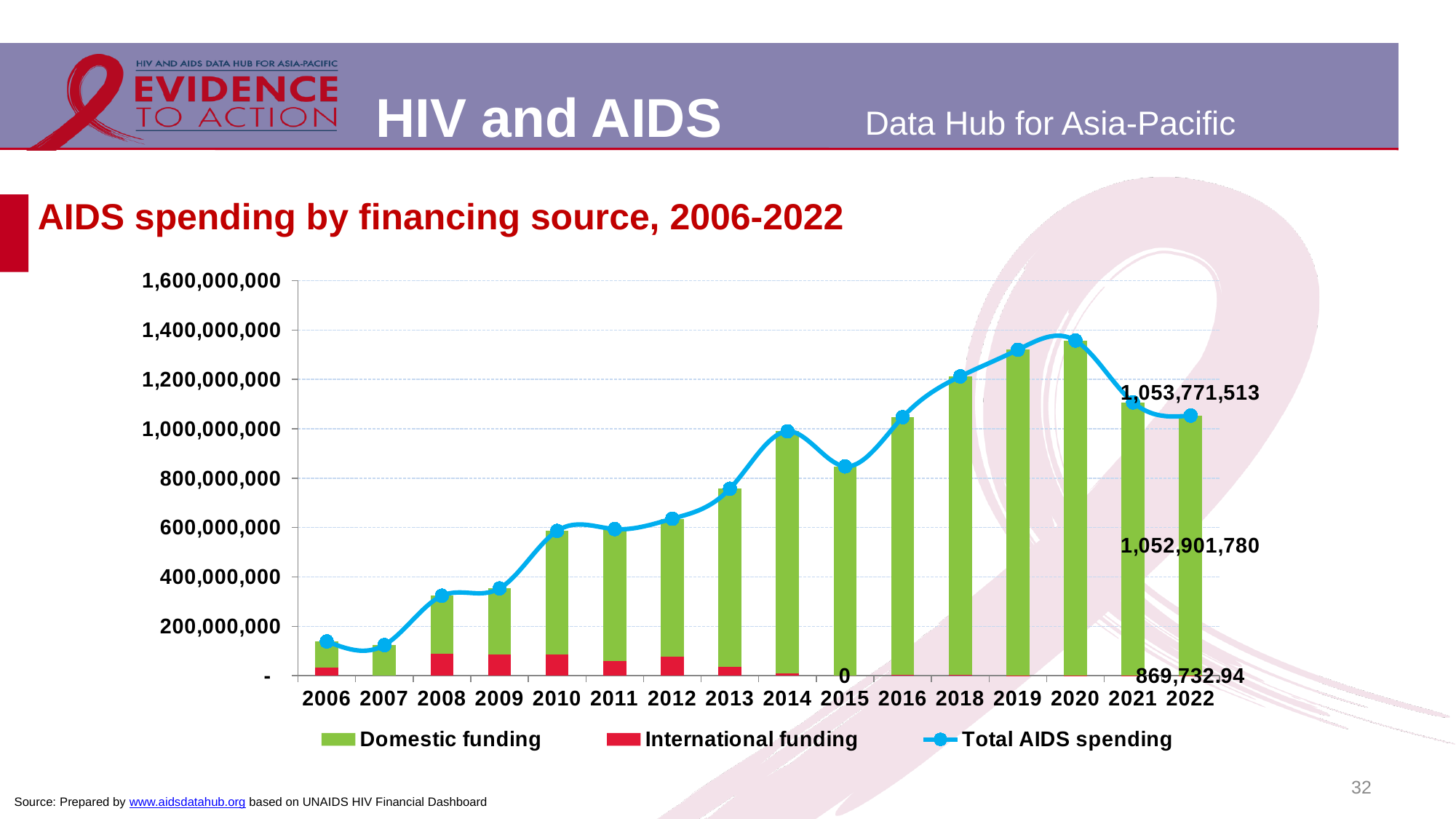
How many series does the legend list? 3 In which year is Total AIDS spending lowest? 2007 In which year is Total AIDS spending highest? 2020 What is the difference between Domestic funding and International funding in 2022? 1,052,032,047.06 Is Total AIDS spending higher in 2020 or in 2021? 2020 How many years are shown on the x axis? 16 What is the International funding value labelled for 2022? 869,732.94 What is the Domestic funding value labelled for 2022? 1,052,901,780 What is the Total AIDS spending value labelled for 2022? 1,053,771,513 Does Total AIDS spending generally rise or fall from 2006 to 2020? rise Is the Total AIDS spending for 2020 greater or less than 1,200,000,000? greater What is the International funding value labelled for 2015? 0